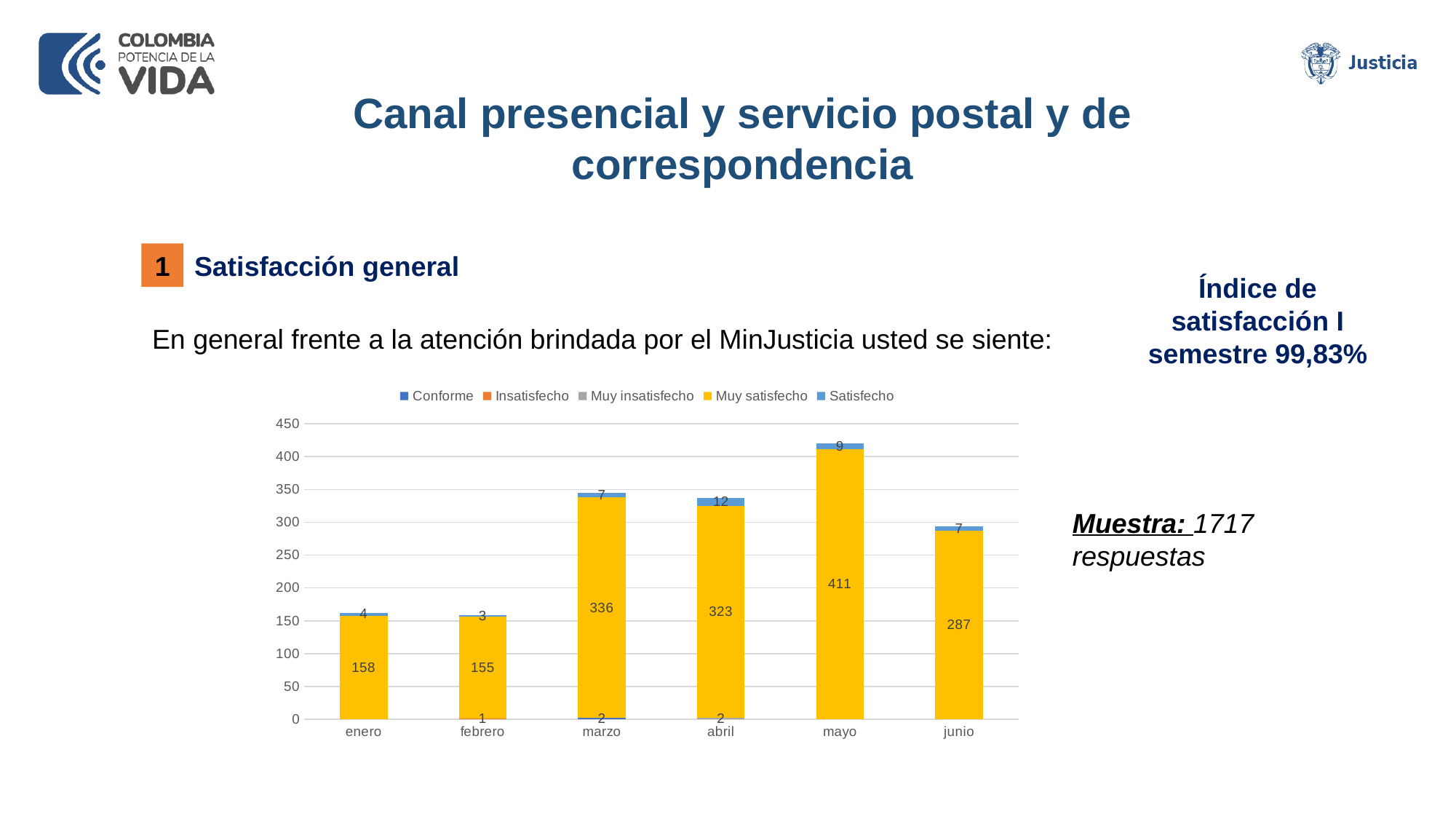
Which month has the lowest Muy satisfecho value? febrero What is the value of Muy satisfecho for febrero? 155 How many months are shown on the x axis? 6 What is the value of Muy satisfecho for mayo? 411 Which is larger, the Muy satisfecho value for marzo or for abril? marzo What is the value of Satisfecho for abril? 12 What kind of chart is shown on the slide? stacked bar chart What is the difference between the Muy satisfecho values for mayo and junio? 124 Which month has the highest Muy satisfecho value? mayo Is the total height of the bar for junio greater or less than 250? greater How many series does the legend list? 5 Which colour represents the Muy satisfecho series? yellow